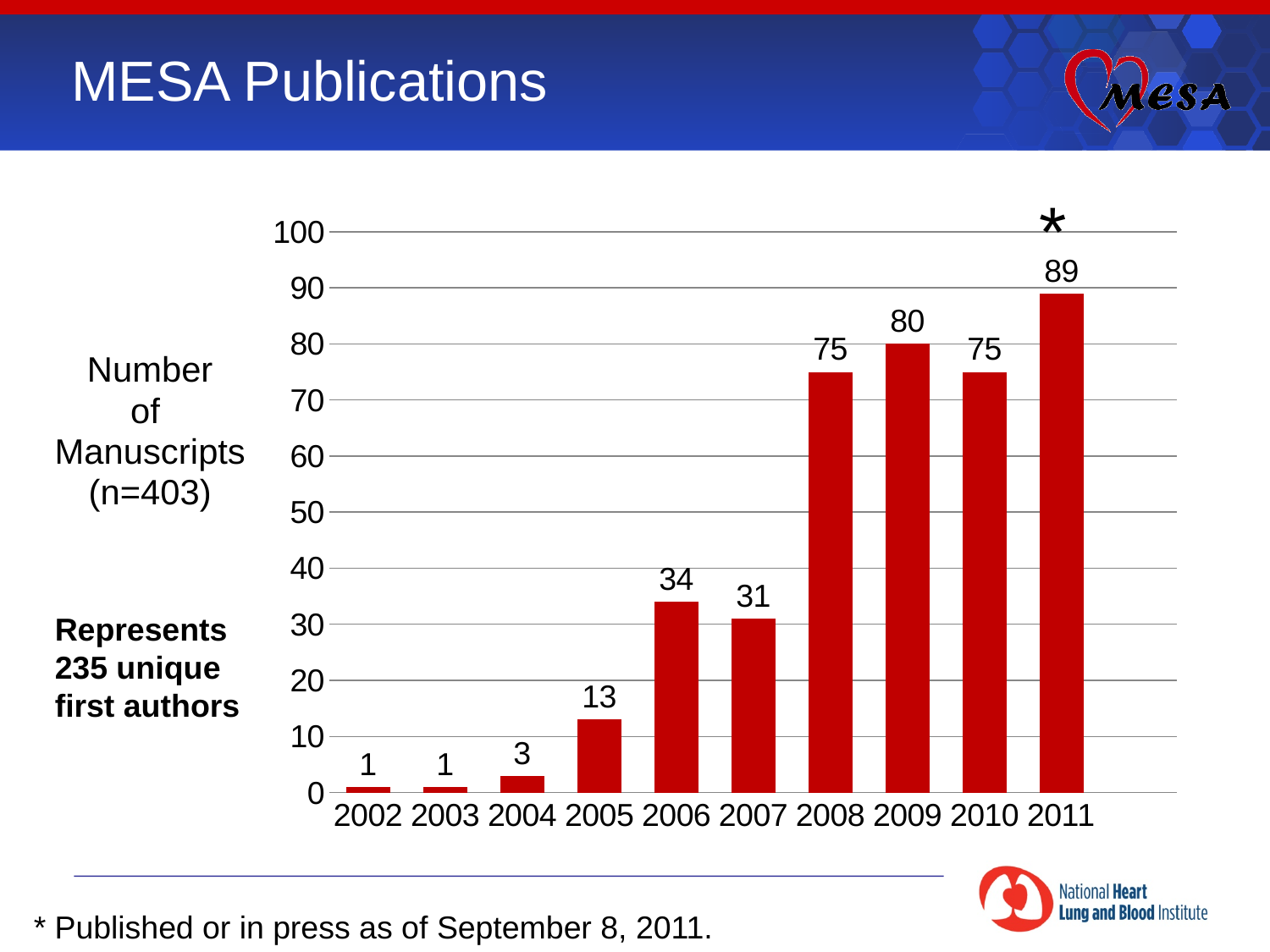
Is the value for 2005 greater or less than 20? less How many manuscripts were published in 2008? 75 What colour are the bars in the chart? red What is the difference in manuscripts between 2005 and 2004? 10 Which year has more manuscripts, 2006 or 2007? 2006 What kind of chart is shown on the slide? bar chart What is the difference in the number of manuscripts between 2011 and 2009? 9 What is the number of manuscripts for 2006? 34 Which year has the highest number of manuscripts? 2011 Do the number of manuscripts generally rise or fall from 2002 to 2011? rise What is the total number of manuscripts given in the y-axis label? 403 How many years are shown on the x axis? 10